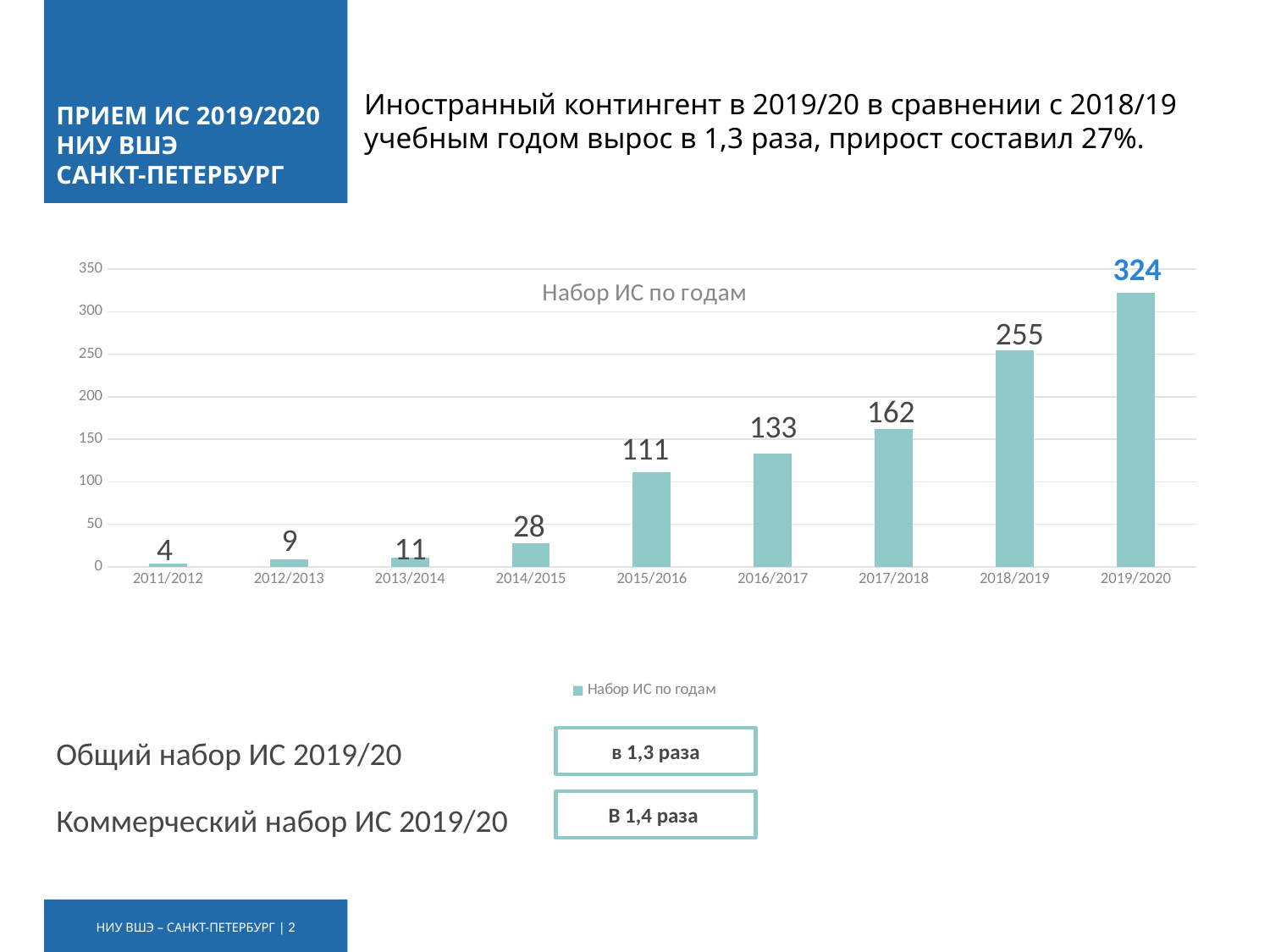
What is the value for 2019/2020 in the chart? 324 What is the difference between the values for 2016/2017 and 2015/2016? 22 Which is larger, the value for 2017/2018 or the value for 2016/2017? 2017/2018 Which year has the lowest value in the chart? 2011/2012 What is the value for 2011/2012 in the chart? 4 What is the value for 2015/2016 in the chart? 111 What kind of chart is shown on the slide? bar chart Which year has the highest value in the chart? 2019/2020 What is the difference between the values for 2019/2020 and 2018/2019? 69 Do the values rise or fall from 2011/2012 to 2019/2020? rise How many years are shown on the x axis of the chart? 9 What is the title of the chart? Набор ИС по годам